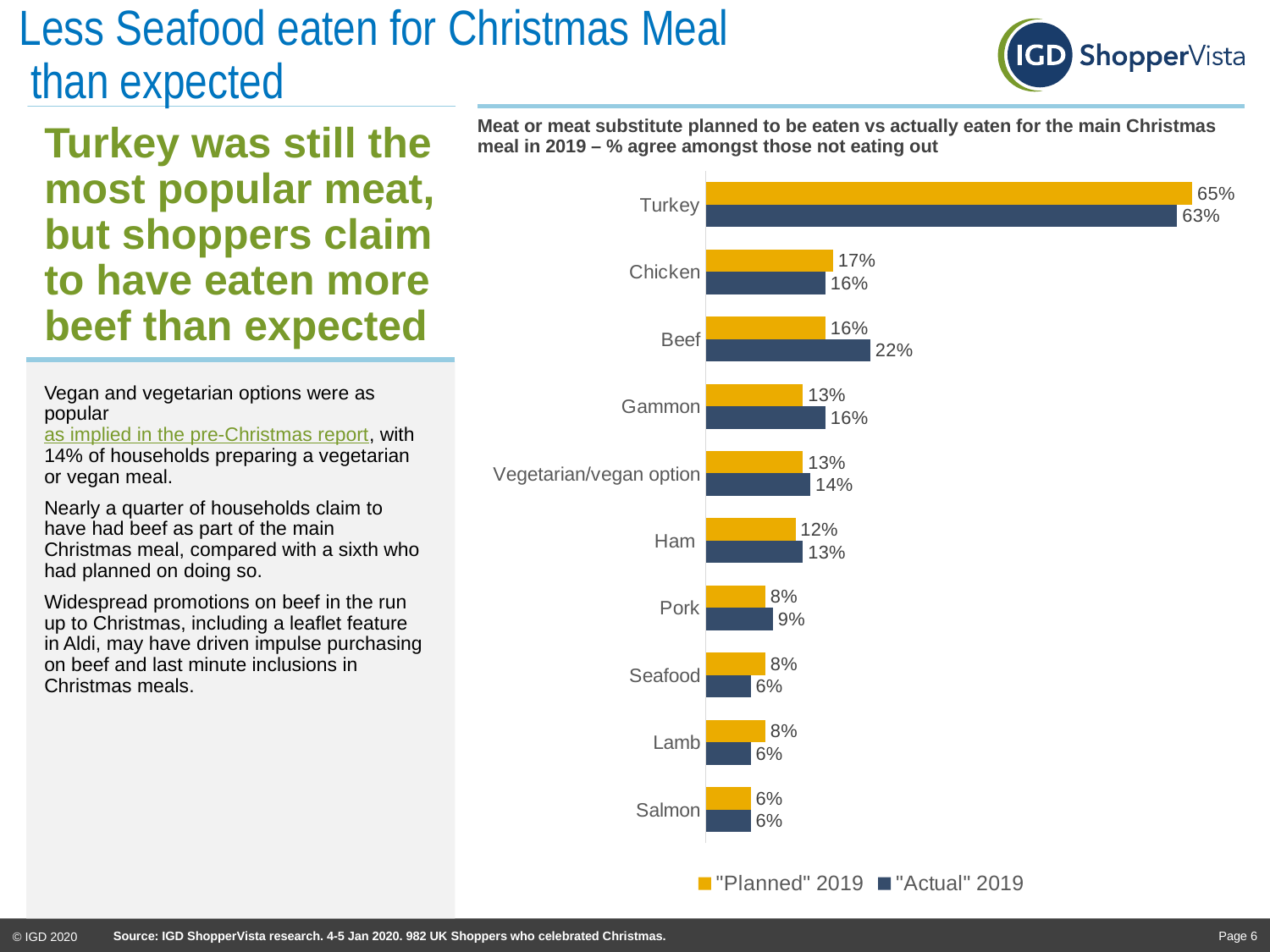
Which category has the highest "Actual" 2019 value? Turkey Which colour represents the "Actual" 2019 series? Dark blue What is the "Actual" 2019 value for Vegetarian/vegan option? 14% How many series does the legend list? 2 What is the difference between the "Actual" 2019 and "Planned" 2019 values for Beef? 6% What is the "Actual" 2019 value for Beef? 22% What kind of chart is shown on the slide? Bar chart Which is larger for Seafood: the "Planned" 2019 value or the "Actual" 2019 value? "Planned" 2019 Which is larger for Gammon: the "Planned" 2019 value or the "Actual" 2019 value? "Actual" 2019 Which category has the lowest "Planned" 2019 value? Salmon What is the "Planned" 2019 value for Turkey? 65% How many categories are shown on the chart? 10